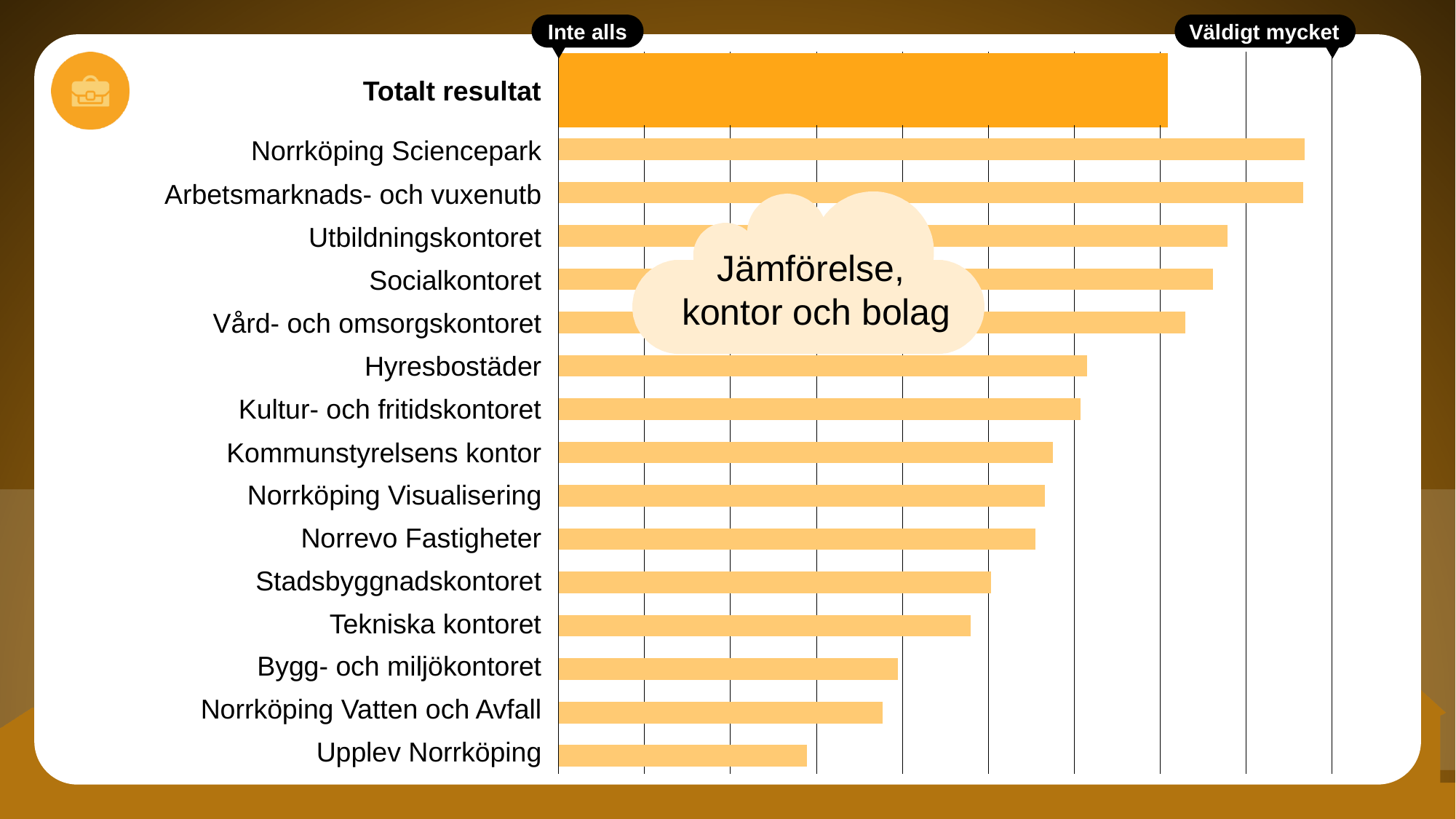
How many individual offices and companies are listed below Totalt resultat? 15 What are the two labels at the ends of the horizontal axis? Inte alls and Väldigt mycket What kind of chart is shown on the slide? Bar chart Which bar is longer: Totalt resultat or Stadsbyggnadskontoret? Totalt resultat Do the bars for the offices and companies get longer or shorter going down the chart? Shorter Which bar is longer: Vård- och omsorgskontoret or Norrevo Fastigheter? Vård- och omsorgskontoret Which category has the shortest bar in the chart? Upplev Norrköping Which bar is longer: Totalt resultat or Norrköping Sciencepark? Norrköping Sciencepark What title is shown in the cloud shape over the chart? Jämförelse, kontor och bolag How many bars are plotted in the chart, including Totalt resultat? 16